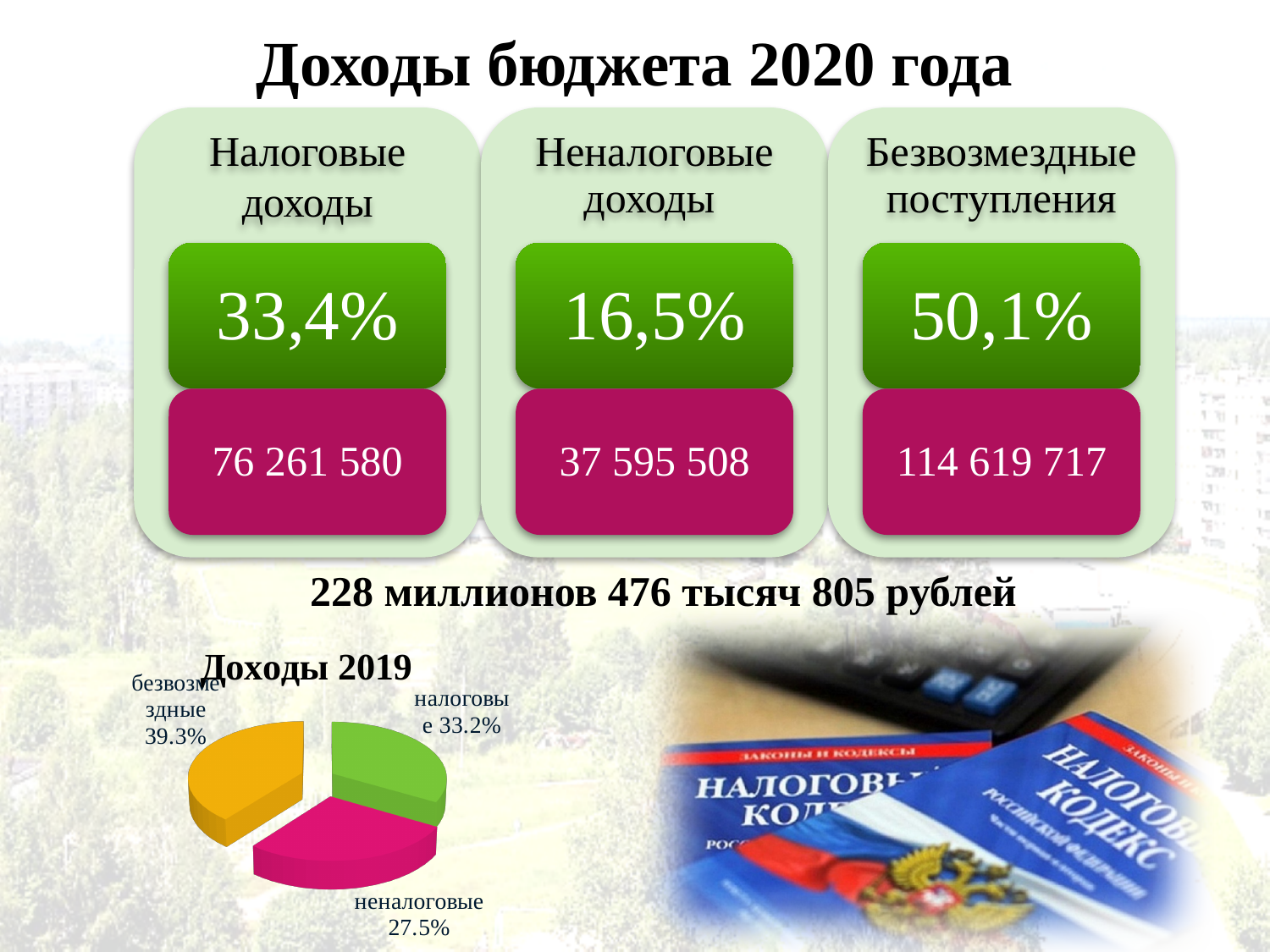
How many slices does the "Доходы 2019" pie chart have? 3 In the "Доходы 2019" pie chart, what is the difference between the налоговые share and the неналоговые share? 5.7% In the "Доходы 2019" pie chart, which is larger: налоговые or неналоговые? налоговые In the "Доходы 2019" pie chart, what is the difference between the безвозмездные share and the налоговые share? 6.1% What is the title of the pie chart on the slide? Доходы 2019 In the "Доходы 2019" pie chart, what share is labelled for налоговые? 33.2% In the "Доходы 2019" pie chart, what share is labelled for безвозмездные? 39.3% In the "Доходы 2019" pie chart, what share is labelled for неналоговые? 27.5% What kind of chart is the "Доходы 2019" chart? pie chart In the "Доходы 2019" pie chart, which slice is the largest? безвозмездные In the "Доходы 2019" pie chart, what colour is the неналоговые slice? pink In the "Доходы 2019" pie chart, which slice is the smallest? неналоговые